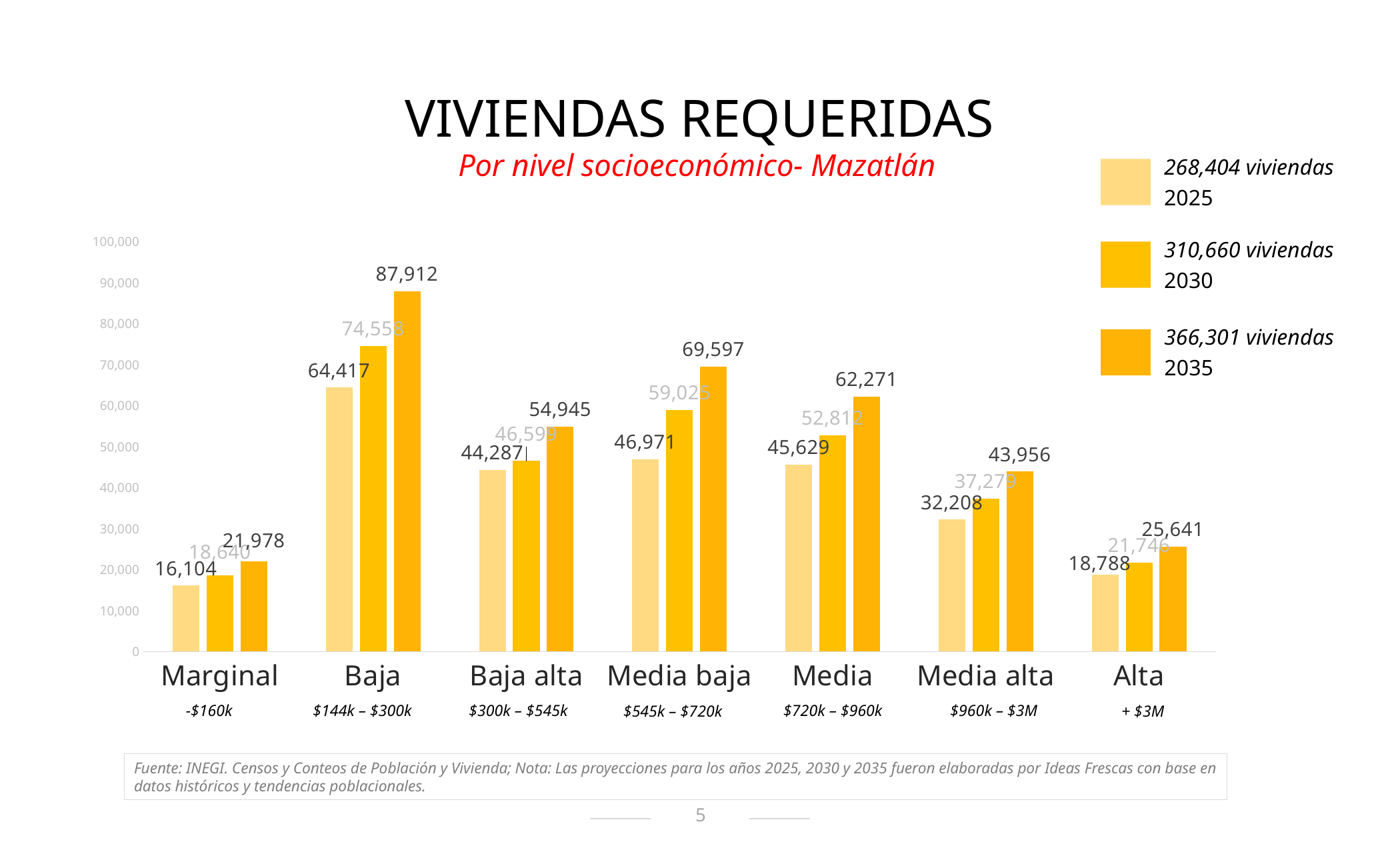
How many housing units are required for the Baja level in 2035? 87,912 Which is larger in 2035: Baja alta or Media? Media Which socioeconomic level has the highest number of required housing units in 2035? Baja According to the legend, what is the total number of viviendas for 2030? 310,660 viviendas Which socioeconomic level has the lowest number of required housing units in 2025? Marginal How many socioeconomic levels are shown on the x axis? 7 What is the 2030 value for the Media baja level? 59,025 How many series does the legend list? 3 What kind of chart is shown on the slide? bar chart Is the 2030 value for Media alta greater or less than 40,000? less What is the 2025 value for the Marginal socioeconomic level? 16,104 What is the difference between the 2035 and 2025 values for the Baja level? 23,495